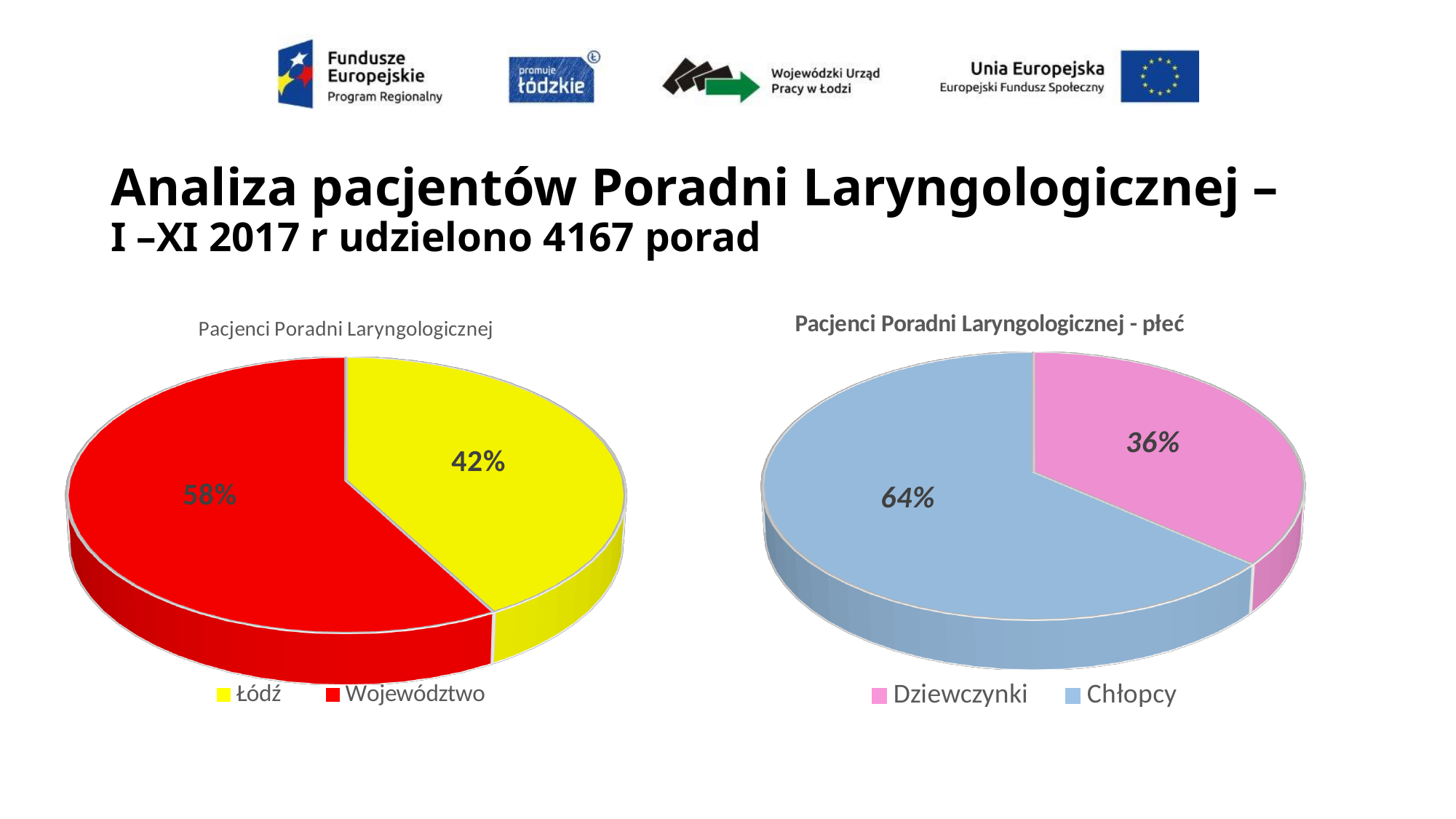
In the chart titled "Pacjenci Poradni Laryngologicznej", what is the difference in percentage points between Województwo and Łódź? 16 In the chart titled "Pacjenci Poradni Laryngologicznej - płeć", which colour represents Chłopcy? Light blue In the chart titled "Pacjenci Poradni Laryngologicznej - płeć", what share of patients are Dziewczynki? 36% In the chart titled "Pacjenci Poradni Laryngologicznej - płeć", which category has the smaller share? Dziewczynki How many categories does the legend of the chart titled "Pacjenci Poradni Laryngologicznej - płeć" list? 2 What type of chart is the left chart, "Pacjenci Poradni Laryngologicznej"? Pie chart In the chart titled "Pacjenci Poradni Laryngologicznej", what share of patients is from Województwo? 58% In the chart titled "Pacjenci Poradni Laryngologicznej - płeć", what share of patients are Chłopcy? 64% In the chart titled "Pacjenci Poradni Laryngologicznej - płeć", what is the difference in percentage points between Chłopcy and Dziewczynki? 28 In the chart titled "Pacjenci Poradni Laryngologicznej", which category has the larger share? Województwo In the chart titled "Pacjenci Poradni Laryngologicznej", what share of patients is from Łódź? 42% In the chart titled "Pacjenci Poradni Laryngologicznej", which colour represents Łódź? Yellow